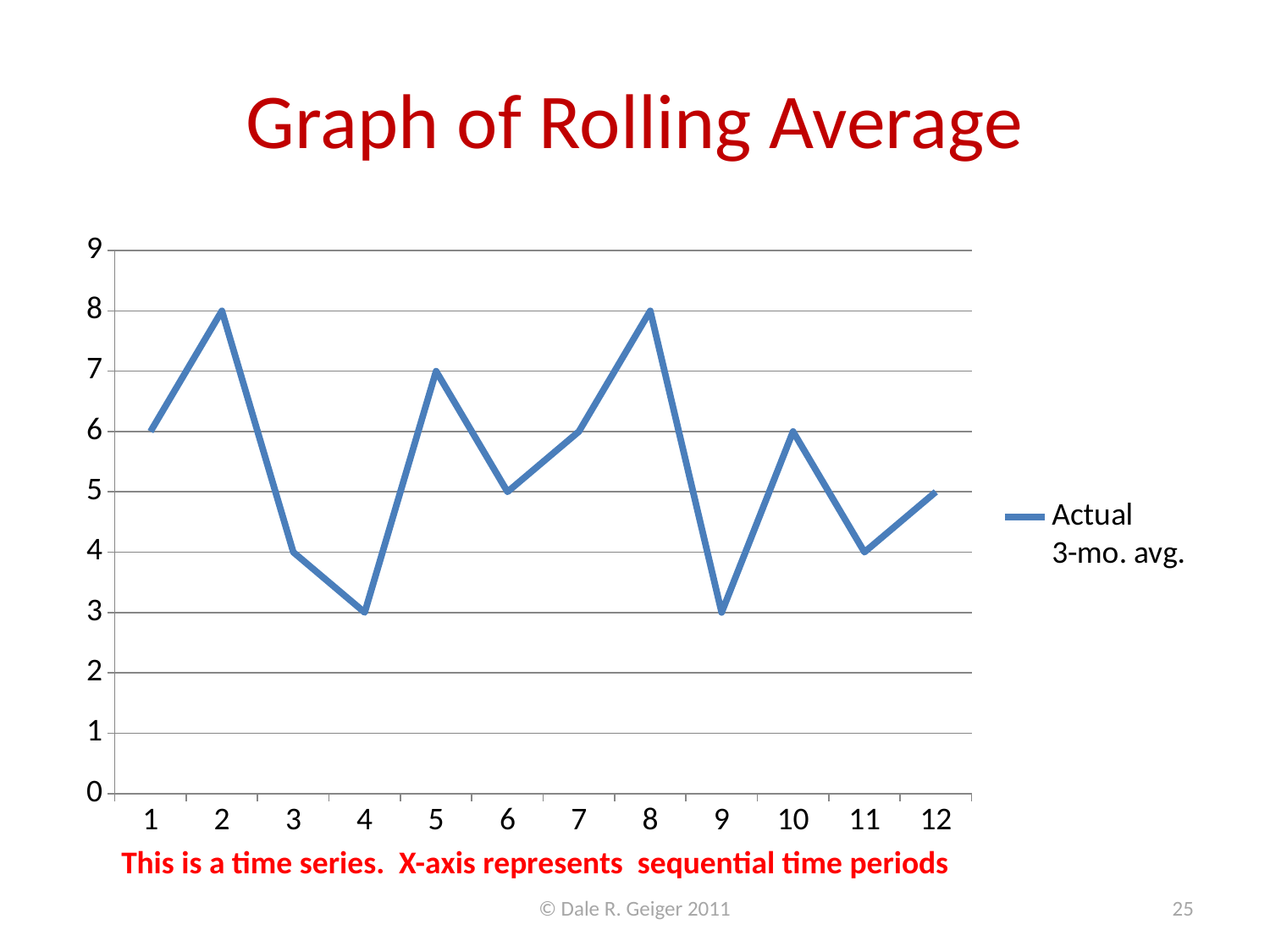
What type of chart is shown on the slide? line chart What is the Actual value at time period 12? 5 What is the title of the chart? Graph of Rolling Average Which time period has the larger Actual value, period 6 or period 7? 7 What is the lowest value reached by the Actual line? 3 What is the highest value reached by the Actual line? 8 What is the Actual value at time period 4? 3 How many time periods are plotted on the x-axis? 12 What is the Actual value at time period 2? 8 What is the Actual value at time period 5? 7 What is the difference between the Actual values at time periods 8 and 9? 5